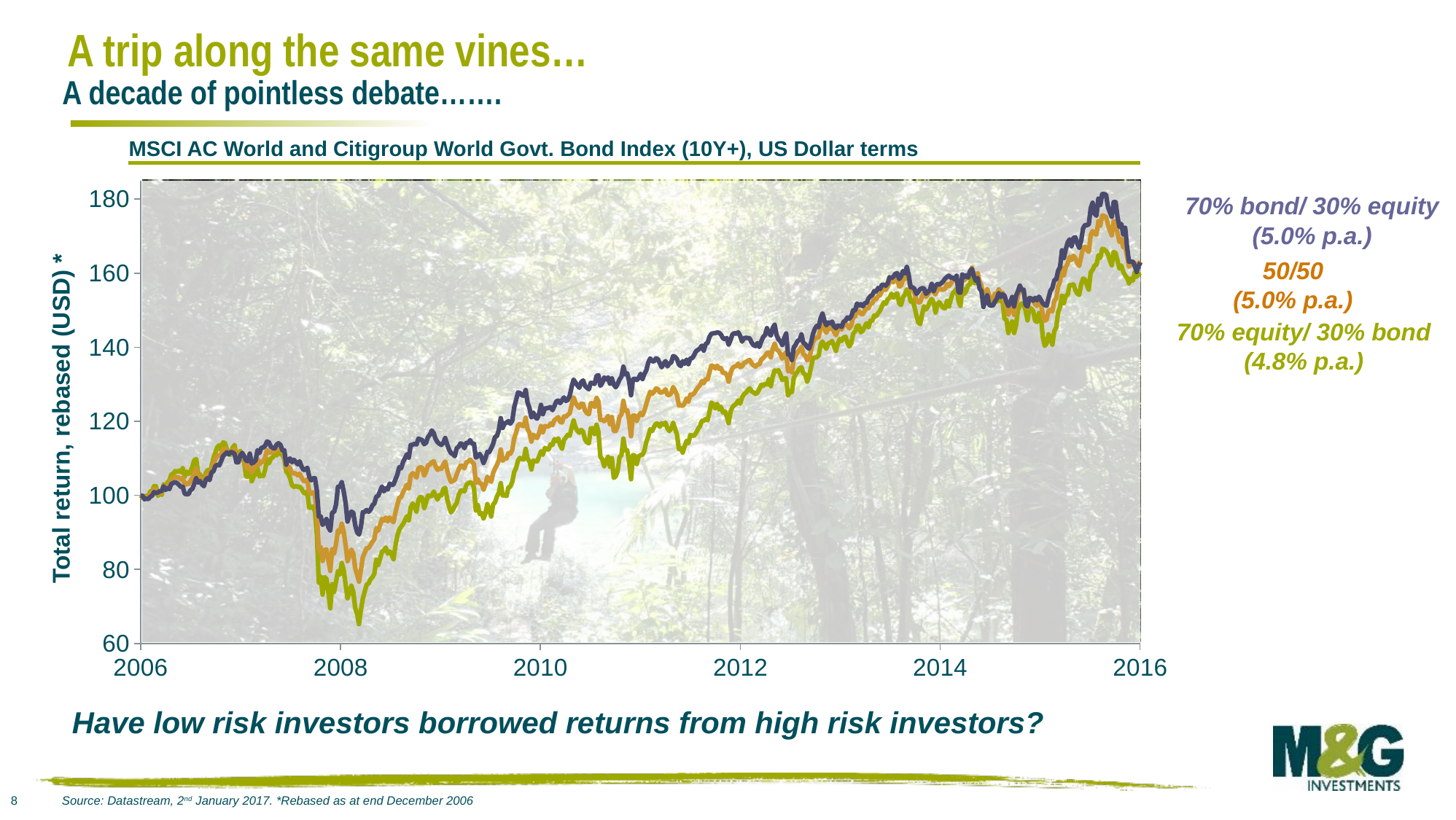
What is the label on the vertical axis of the chart? Total return, rebased (USD) * What is the title of the chart? MSCI AC World and Citigroup World Govt. Bond Index (10Y+), US Dollar terms What annualised return is shown for the 70% equity/ 30% bond portfolio? 4.8% p.a. Overall, do the total return lines rise or fall from 2006 to 2016? Rise Which portfolio mix has the lowest annualised return shown on the slide? 70% equity/ 30% bond What annualised return is shown for the 70% bond/ 30% equity portfolio? 5.0% p.a. How many series (portfolio mixes) are plotted on the chart? 3 At what value do all three lines start in 2006? 100 Is the lowest point of the 70% bond/ 30% equity line around 2008 greater or less than 80? greater What kind of chart is shown on the slide? Line chart Which portfolio line falls the furthest during the 2008 downturn? 70% equity/ 30% bond Is the lowest point of the 70% equity/ 30% bond line around 2008-2009 greater or less than 80? less